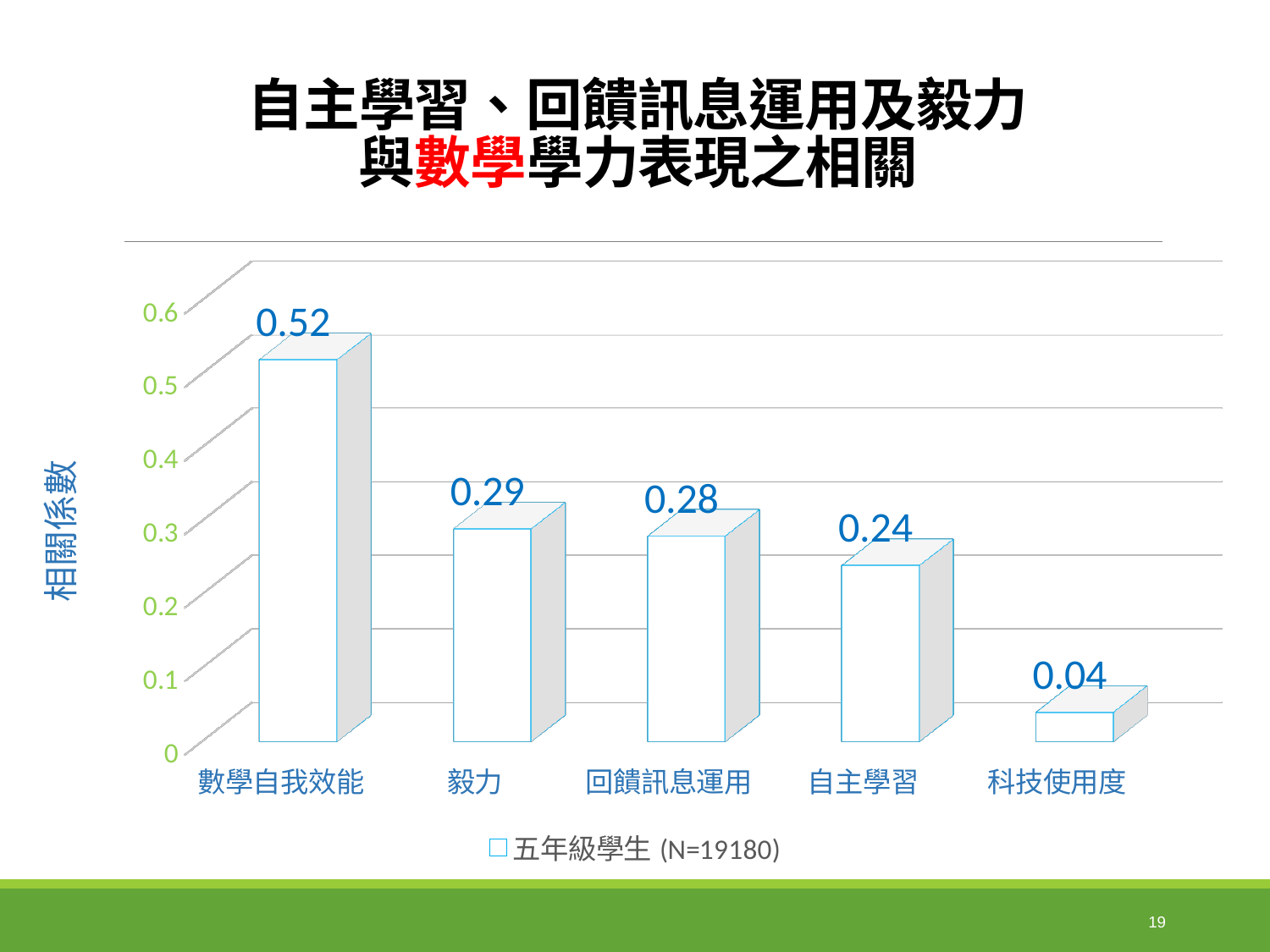
Which has a larger correlation coefficient, 毅力 or 自主學習? 毅力 What kind of chart is shown on the slide? bar chart Which category has the lowest correlation coefficient? 科技使用度 What is the correlation coefficient for 數學自我效能? 0.52 What is the correlation coefficient for 毅力? 0.29 Which category has the highest correlation coefficient? 數學自我效能 What is the difference between the correlation coefficients for 數學自我效能 and 自主學習? 0.28 How many categories are shown on the x axis? 5 What is the correlation coefficient for 科技使用度? 0.04 What series does the legend list? 五年級學生 (N=19180) What is the correlation coefficient for 回饋訊息運用? 0.28 What is the correlation coefficient for 自主學習? 0.24